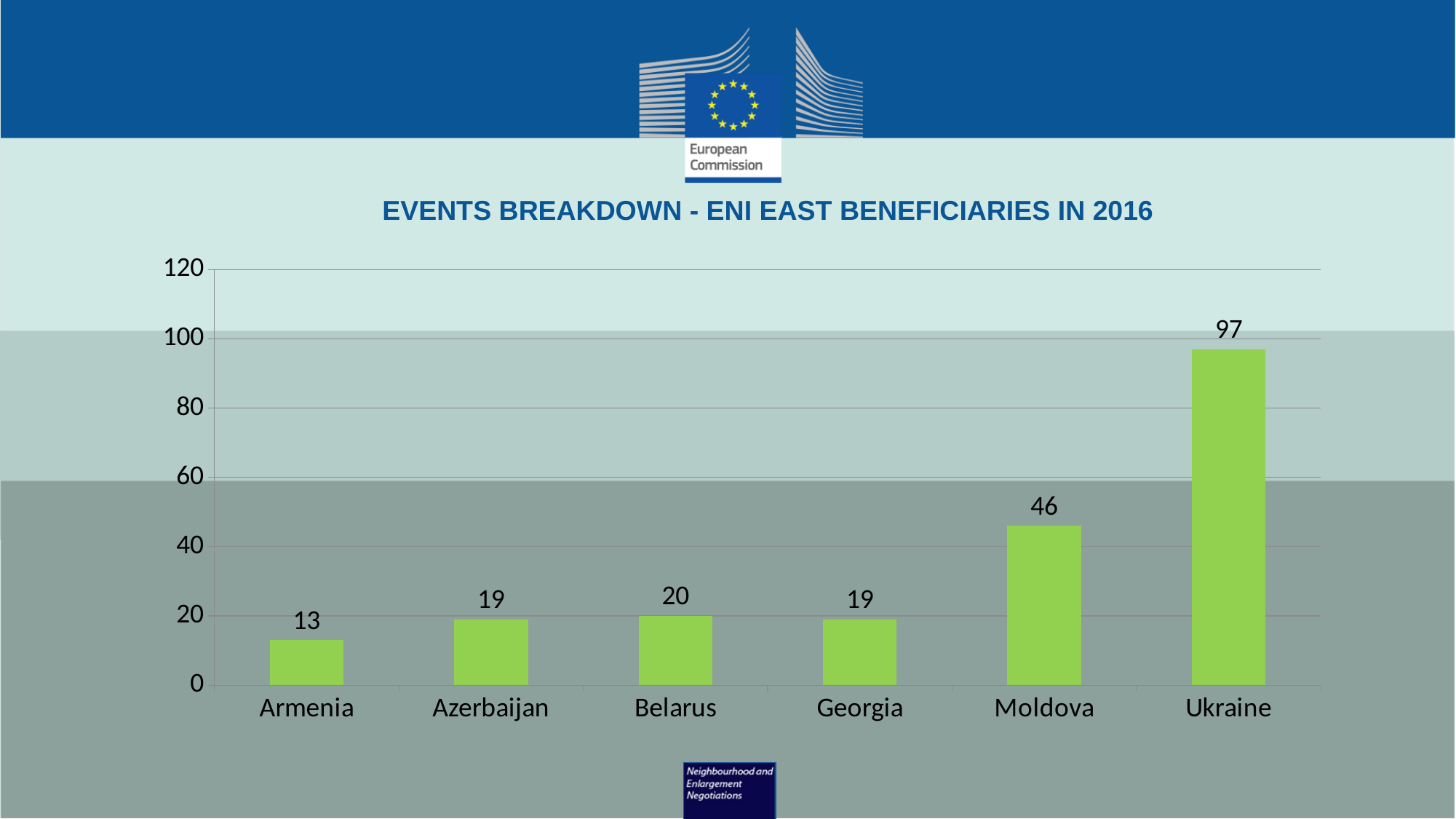
How many countries are shown on the chart? 6 Which country has the highest value? Ukraine What is the title of the chart? EVENTS BREAKDOWN - ENI EAST BENEFICIARIES IN 2016 What is the value for Ukraine? 97 What is the value for Moldova? 46 Which has a larger value, Moldova or Belarus? Moldova Which country has the lowest value? Armenia What is the value for Belarus? 20 What kind of chart is shown on the slide? Bar chart What is the value for Armenia? 13 What is the difference between the values for Belarus and Armenia? 7 What is the difference between the values for Ukraine and Moldova? 51